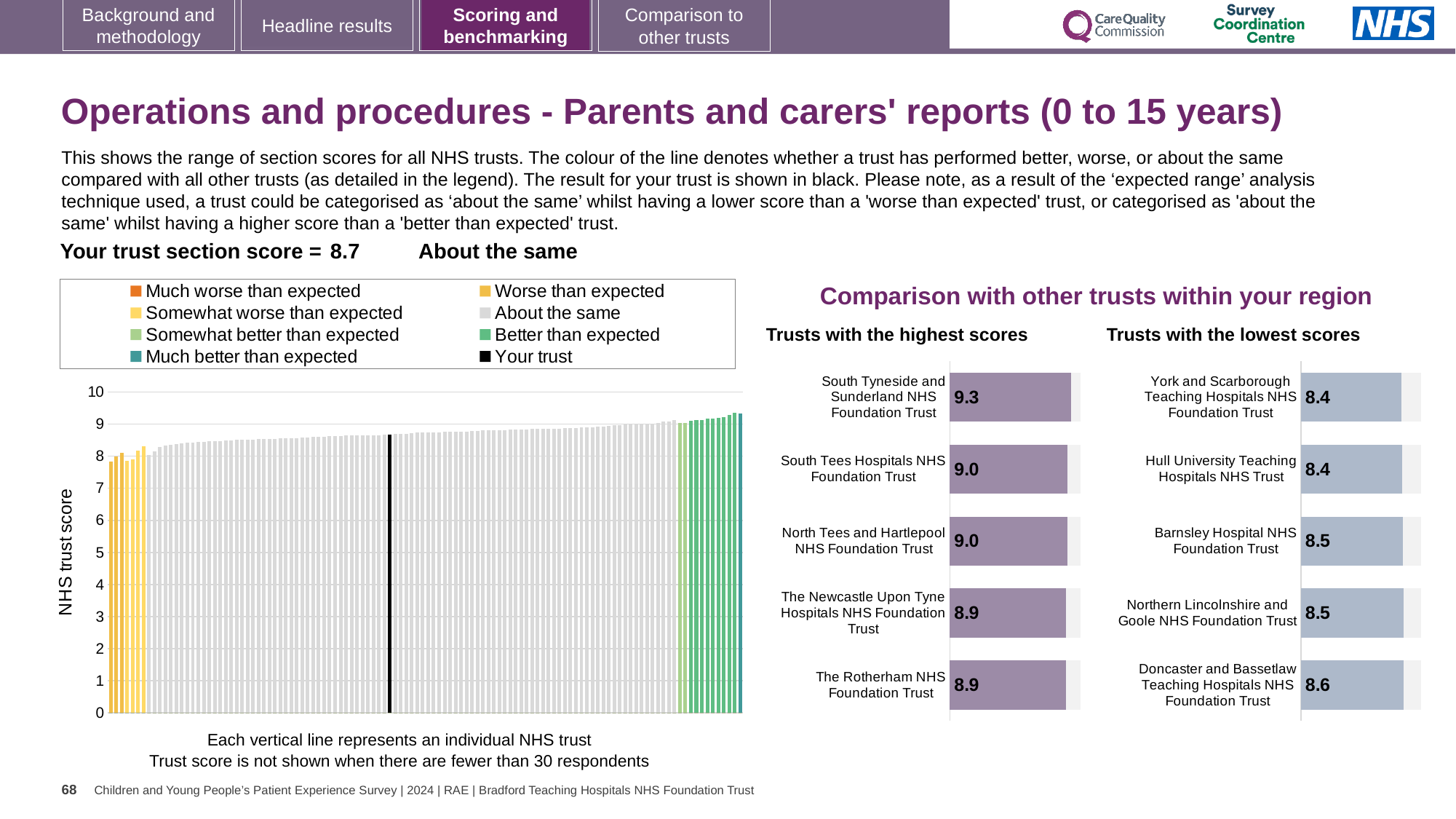
In the 'Trusts with the highest scores' chart, what is the difference between the scores of South Tyneside and Sunderland NHS Foundation Trust and The Rotherham NHS Foundation Trust? 0.4 In the 'Trusts with the lowest scores' chart, which trust has the highest score shown? Doncaster and Bassetlaw Teaching Hospitals NHS Foundation Trust In the 'Trusts with the highest scores' chart, which trust has the highest score? South Tyneside and Sunderland NHS Foundation Trust How many trusts are listed in the 'Trusts with the highest scores' chart? 5 How many entries does the legend of the large chart on the left list? 8 In the large chart on the left, do the trust scores rise or fall from left to right? Rise In the 'Trusts with the highest scores' chart, what is the score for South Tyneside and Sunderland NHS Foundation Trust? 9.3 What kind of chart is the large chart on the left showing NHS trust scores? Bar chart In the 'Trusts with the highest scores' chart, what is the score for The Rotherham NHS Foundation Trust? 8.9 In the 'Trusts with the lowest scores' chart, which has the larger score: Barnsley Hospital NHS Foundation Trust or Doncaster and Bassetlaw Teaching Hospitals NHS Foundation Trust? Doncaster and Bassetlaw Teaching Hospitals NHS Foundation Trust In the 'Trusts with the lowest scores' chart, what is the difference between the scores of Doncaster and Bassetlaw Teaching Hospitals NHS Foundation Trust and Hull University Teaching Hospitals NHS Trust? 0.2 In the 'Trusts with the lowest scores' chart, what is the score for Doncaster and Bassetlaw Teaching Hospitals NHS Foundation Trust? 8.6